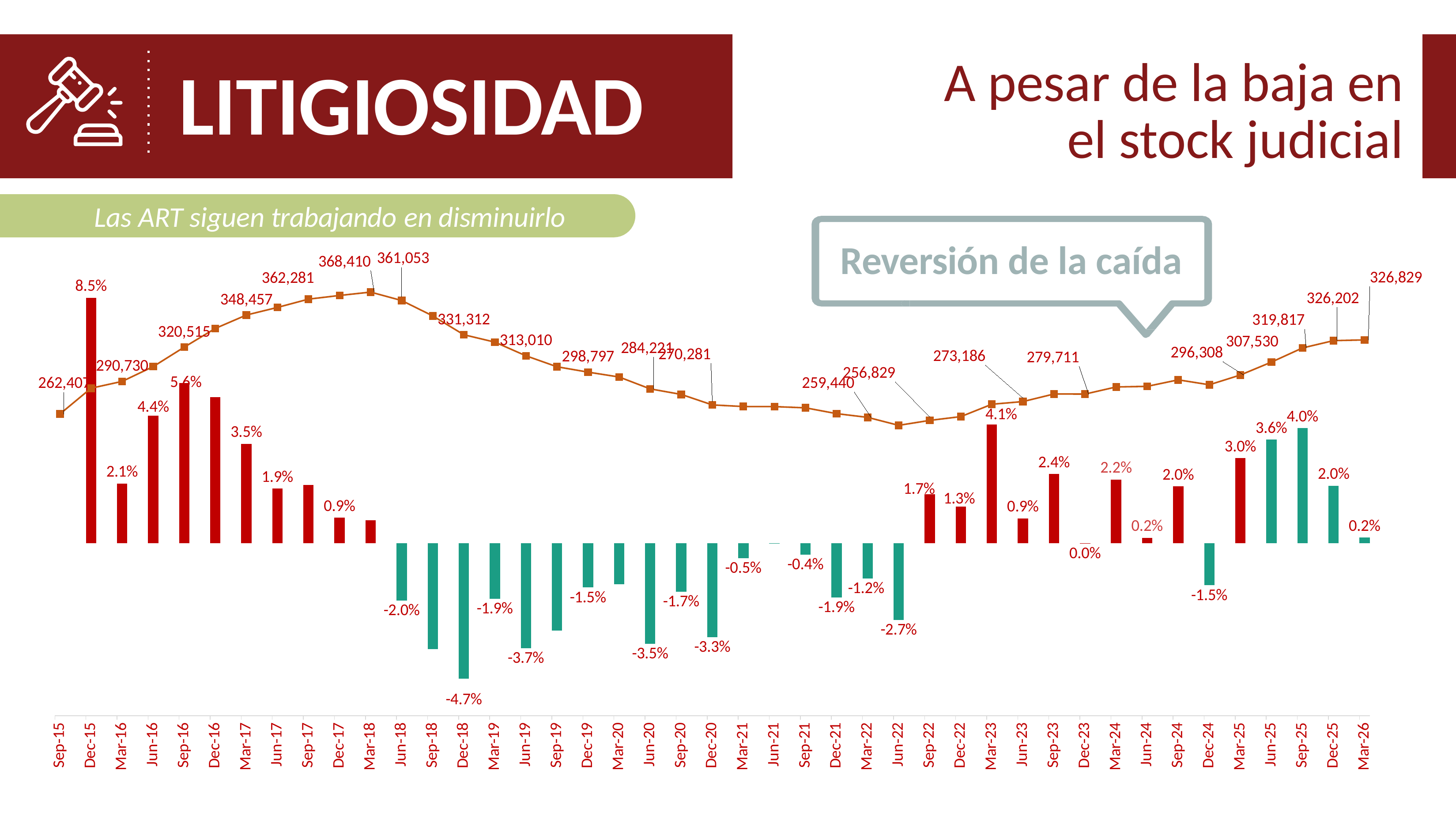
Which period has the lowest bar value? Dec-18 What is the value of the line series at Sep-15? 262,407 What kinds of chart are combined on this slide? A bar chart and a line chart What is the value of the line series at Mar-26? 326,829 What is the percentage change shown by the bar for Dec-15? 8.5% What is the percentage change shown by the bar for Mar-23? 4.1% Does the line series rise or fall between Mar-18 and Jun-22? Fall At which period does the line series reach its highest value? Mar-18 What is the difference between the line values at Mar-26 (326,829) and Dec-25 (326,202)? 627 What is the percentage change shown by the bar for Dec-18? -4.7% What is the value of the line series at Mar-18? 368,410 Which bar is larger, Sep-25 or Jun-25? Sep-25